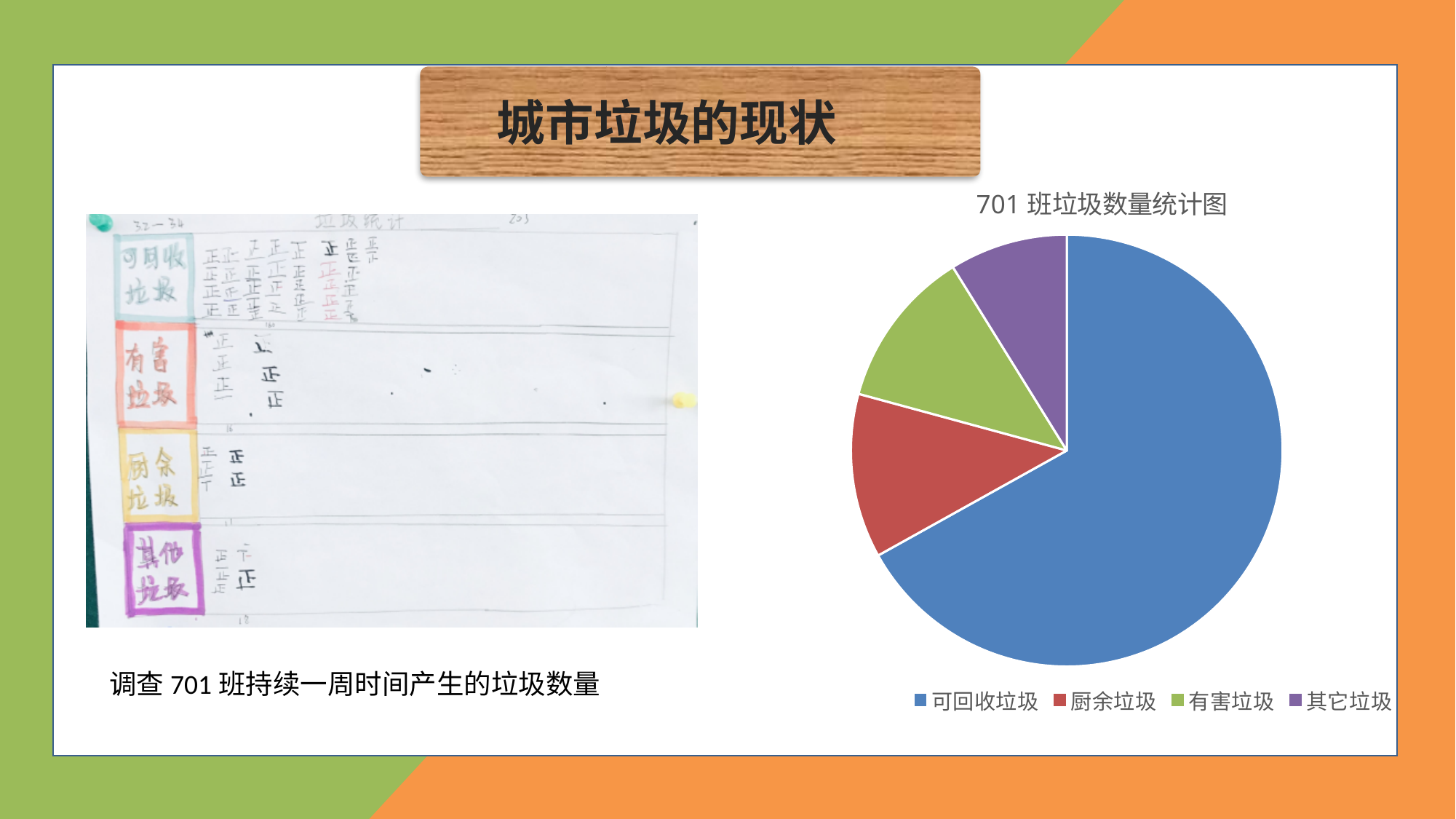
What is the title of the pie chart on the slide? 701 班垃圾数量统计图 In the pie chart, which is larger: 可回收垃圾 or 厨余垃圾? 可回收垃圾 What kind of chart is the "701 班垃圾数量统计图"? pie chart In the pie chart, which is larger: 可回收垃圾 or 其它垃圾? 可回收垃圾 Which category has the largest slice in the pie chart "701 班垃圾数量统计图"? 可回收垃圾 How many entries does the legend of the pie chart list? 4 Which colour represents 厨余垃圾 in the pie chart? red In the pie chart, which is larger: 有害垃圾 or 可回收垃圾? 可回收垃圾 How many categories does the pie chart "701 班垃圾数量统计图" show? 4